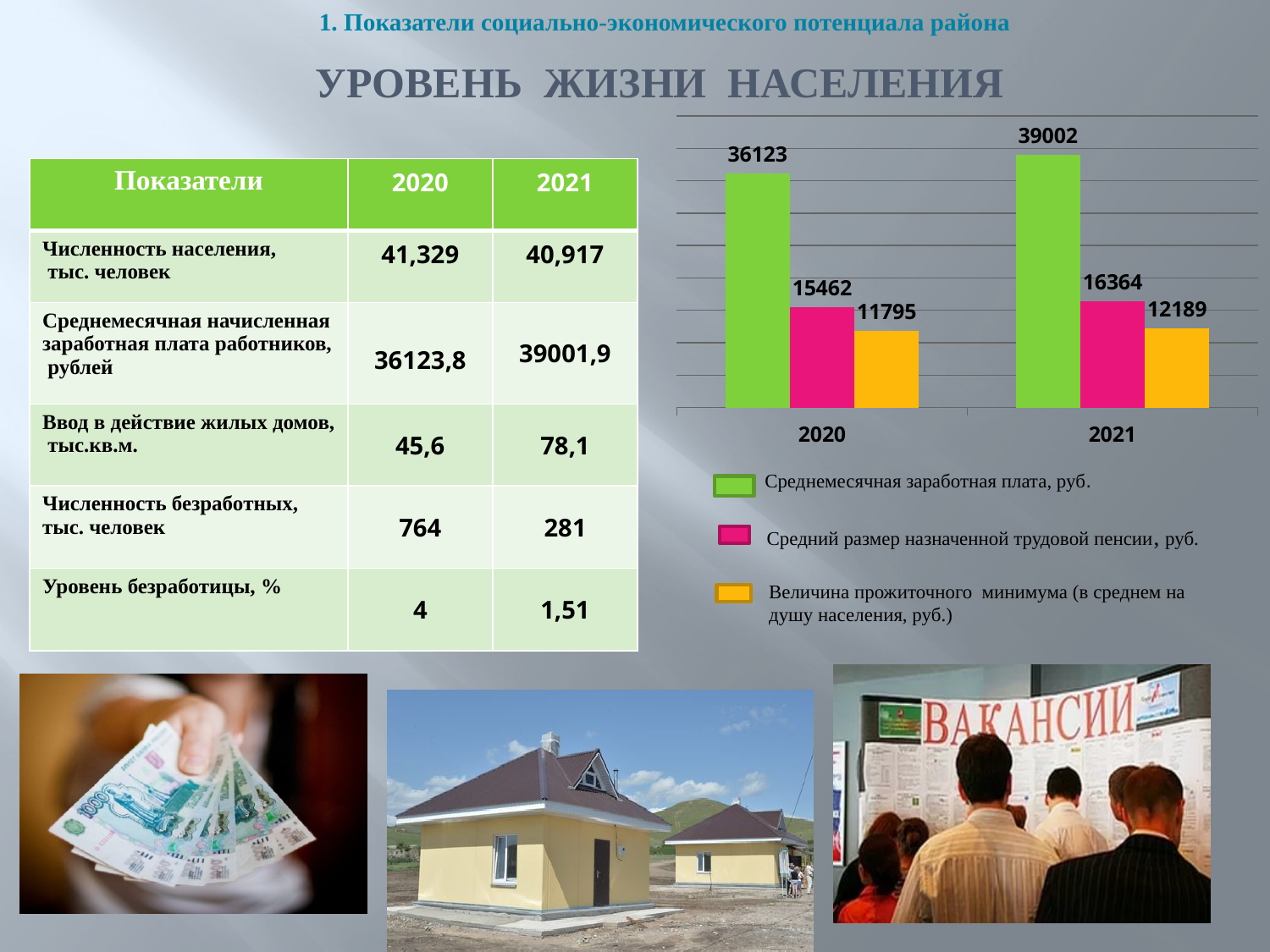
What type of chart is shown on the slide? Bar chart By how much did Среднемесячная заработная плата increase from 2020 to 2021? 2879 Which year has the higher Среднемесячная заработная плата, 2020 or 2021? 2021 Which series has the lowest value in 2020? Величина прожиточного минимума What is the value of Величина прожиточного минимума for 2021? 12189 Which colour represents Средний размер назначенной трудовой пенсии in the chart? Pink What is the value of Среднемесячная заработная плата for 2020 in the chart? 36123 What is the difference between Средний размер назначенной трудовой пенсии and Величина прожиточного минимума in 2021? 4175 How many series does the chart legend list? 3 What is the value of Среднемесячная заработная плата for 2021 in the chart? 39002 What is the value of Средний размер назначенной трудовой пенсии for 2020? 15462 How many years (categories) are shown on the x axis of the chart? 2